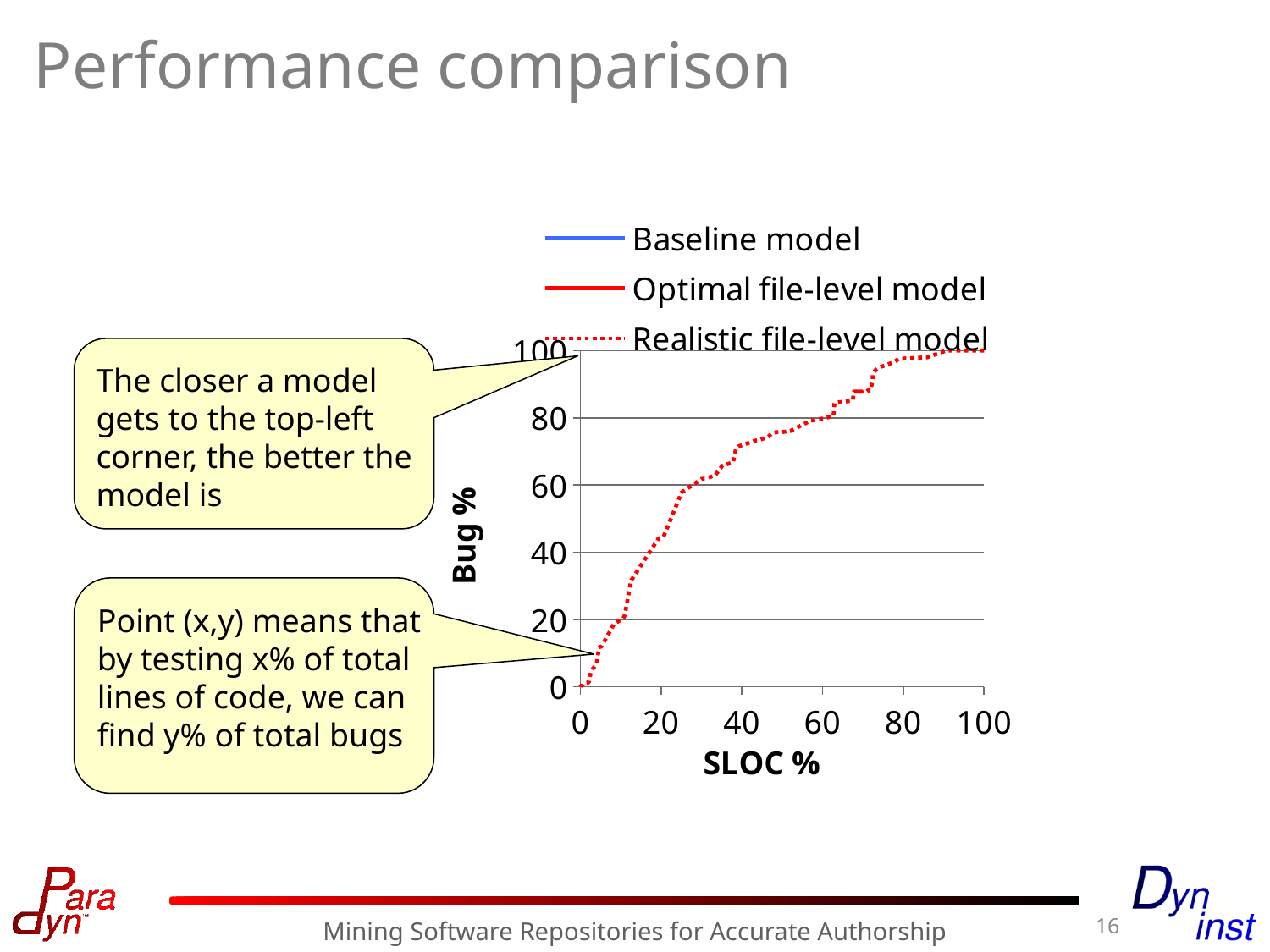
Is the Bug % value of the Realistic file-level model at 80 SLOC % greater or less than 80? greater Is the Bug % value of the Realistic file-level model at 5 SLOC % greater or less than 20? less How many series does the chart legend list? 3 Does the Realistic file-level model line rise or fall as SLOC % increases? rise What kind of chart is shown on the slide? line chart What is the highest value shown on the Bug % axis of the chart? 100 Is the Bug % value of the Realistic file-level model at 50 SLOC % greater or less than 80? less What is the title of the vertical axis of the chart? Bug % What is the title of the horizontal axis of the chart? SLOC %